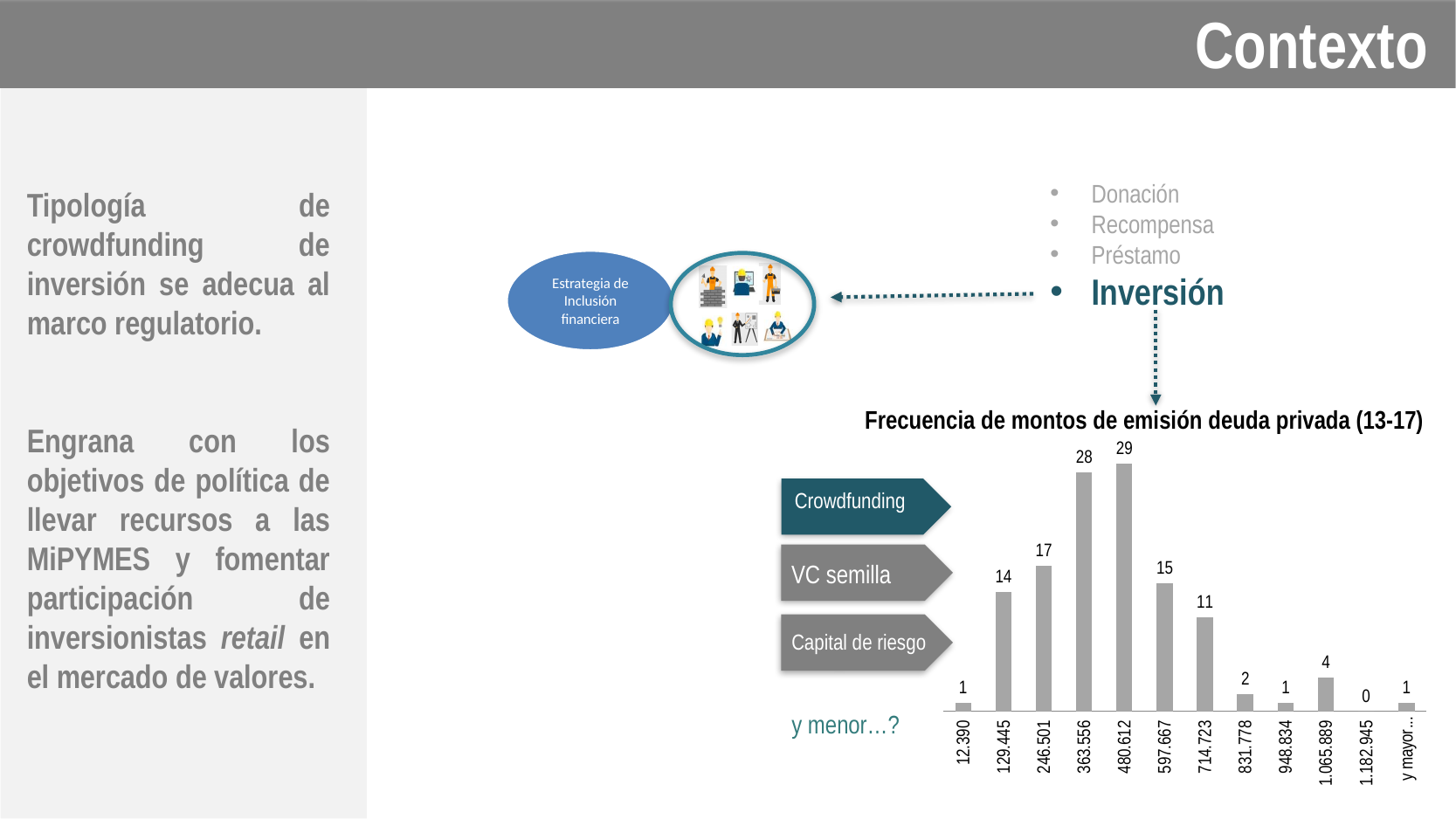
What kind of chart is shown on the slide? Bar chart What is the value for the 1.065.889 category? 4 What is the value for the 129.445 category? 14 What is the difference between the values for 597.667 and 714.723? 4 How many categories are shown on the x axis of the chart? 12 What is the value for the 480.612 category in the chart 'Frecuencia de montos de emisión deuda privada (13-17)'? 29 Which has a larger value, 363.556 or 597.667? 363.556 Which category has the highest value? 480.612 What is the difference between the values for 480.612 and 363.556? 1 What is the title of the chart on the slide? Frecuencia de montos de emisión deuda privada (13-17) Do the values rise or fall from 12.390 to 480.612 along the x axis? Rise Which category has the lowest value? 1.182.945